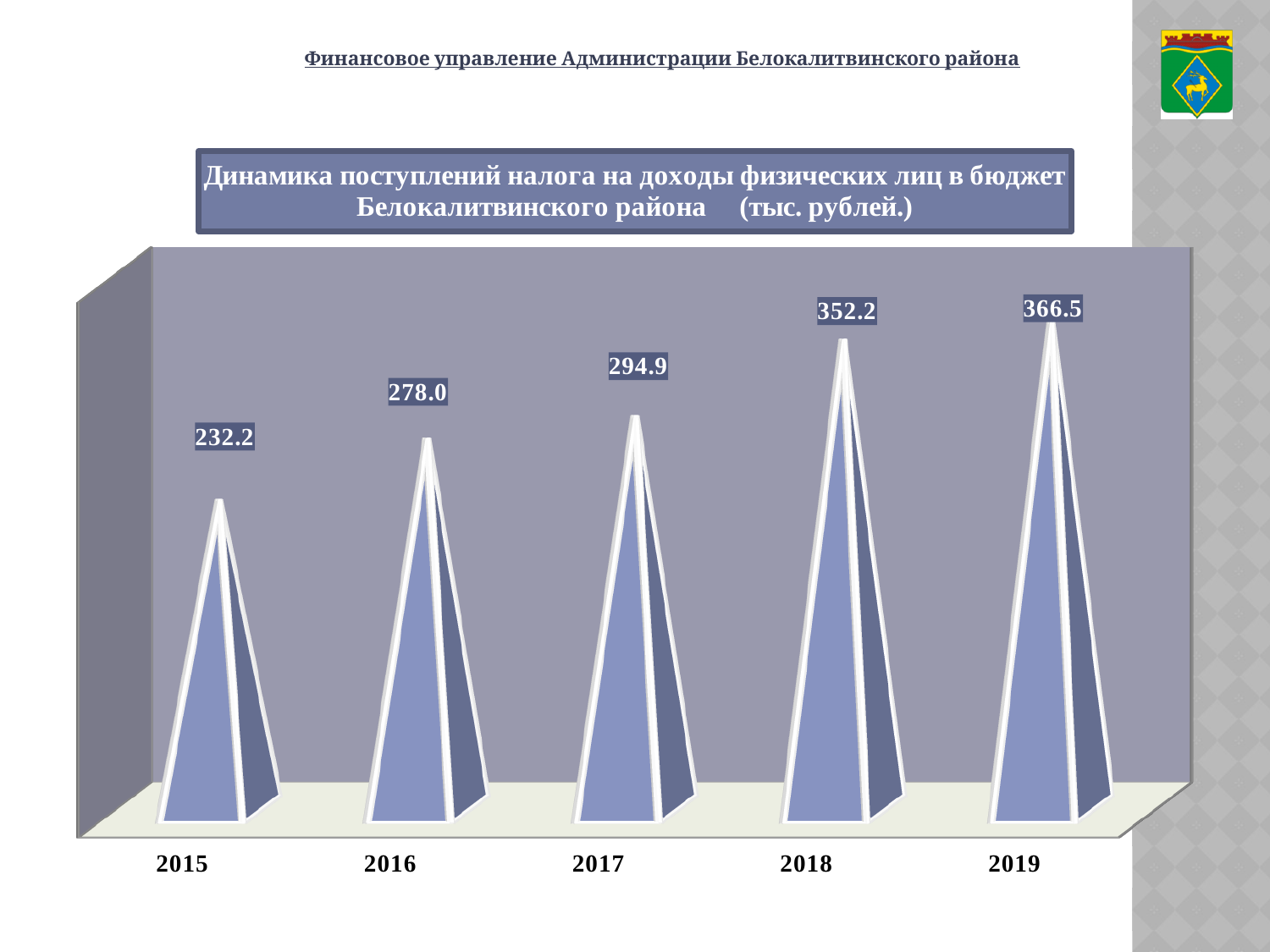
What kind of chart is shown on the slide? bar chart In what units are the values on the chart expressed, according to the title? тыс. рублей What is the value for 2019? 366.5 Do the values rise or fall from 2015 to 2019? rise Which year has the lowest value? 2015 What is the difference between the values for 2019 and 2015? 134.3 What is the value for 2015? 232.2 What is the value for 2017? 294.9 How many years are shown on the chart? 5 What is the difference between the values for 2018 and 2017? 57.3 Which year has the highest value? 2019 Which is larger, the value for 2016 or the value for 2017? 2017